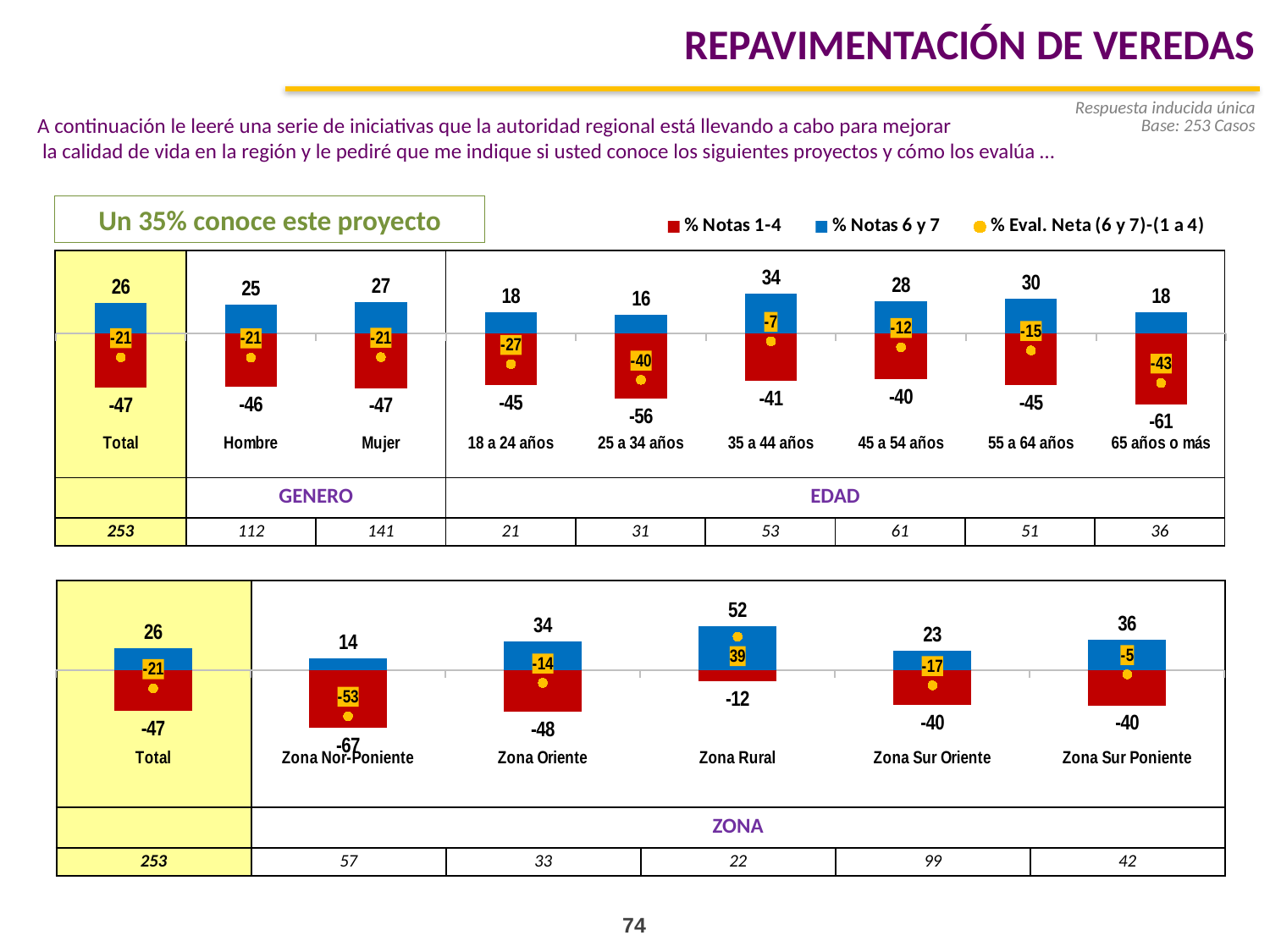
What kind of chart is the bottom chart? Combination bar and line chart (stacked bars with dot markers for the net evaluation) In the top chart, which category has the lowest % Eval. Neta value? 65 años o más In the top chart, what is the % Eval. Neta value for 25 a 34 años? -40 How many series does the legend list? 3 In the top chart, what is the % Notas 1-4 value for 65 años o más? -61 In the bottom chart, which zone has the highest % Eval. Neta value? Zona Rural In the bottom chart, is the % Notas 6 y 7 value larger for Zona Oriente or Zona Sur Oriente? Zona Oriente In the bottom chart, what is the % Notas 6 y 7 value for Zona Rural? 52 In the top chart, what is the difference between the % Notas 6 y 7 values for Mujer and Hombre? 2 In the bottom chart, what is the % Eval. Neta value for Zona Nor-Poniente? -53 In the top chart, which age group has the highest % Notas 6 y 7 value? 35 a 44 años In the top chart, what is the % Notas 6 y 7 value for 35 a 44 años? 34